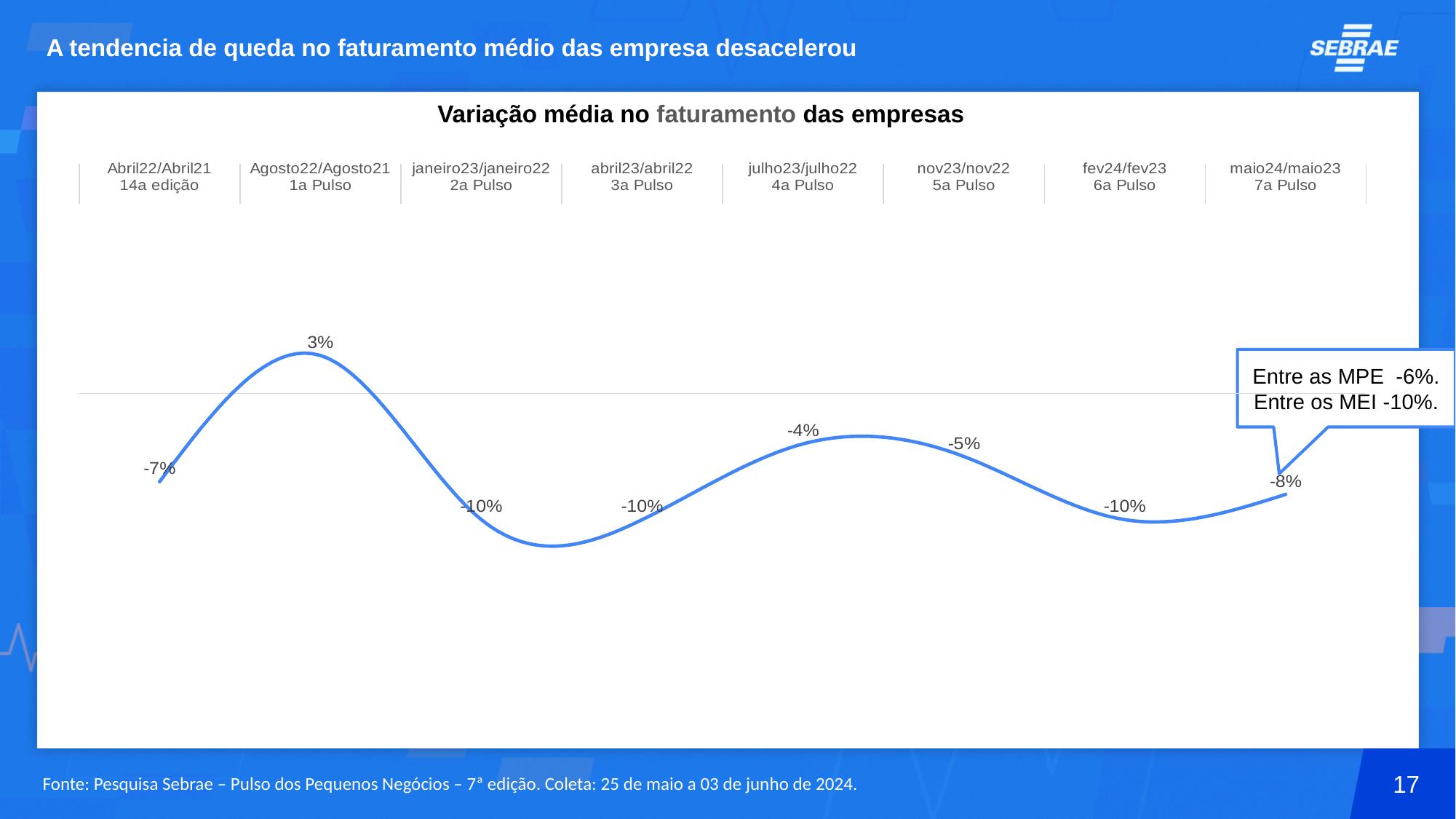
How many periods are plotted on the chart? 8 According to the callout, what is the variation among the MEI? -10% What is the value for Agosto22/Agosto21 (1a Pulso)? 3% Which period has the highest value? Agosto22/Agosto21 (1a Pulso) What is the value for maio24/maio23 (7a Pulso)? -8% What kind of chart is shown? Line chart What is the value for Abril22/Abril21 (14a edição)? -7% Which is larger, the value for julho23/julho22 or the value for maio24/maio23? julho23/julho22 Does the value rise or fall from fev24/fev23 to maio24/maio23? Rise What is the difference between the values for Agosto22/Agosto21 and Abril22/Abril21? 10 percentage points What is the value for julho23/julho22 (4a Pulso)? -4% What is the title of the chart? Variação média no faturamento das empresas